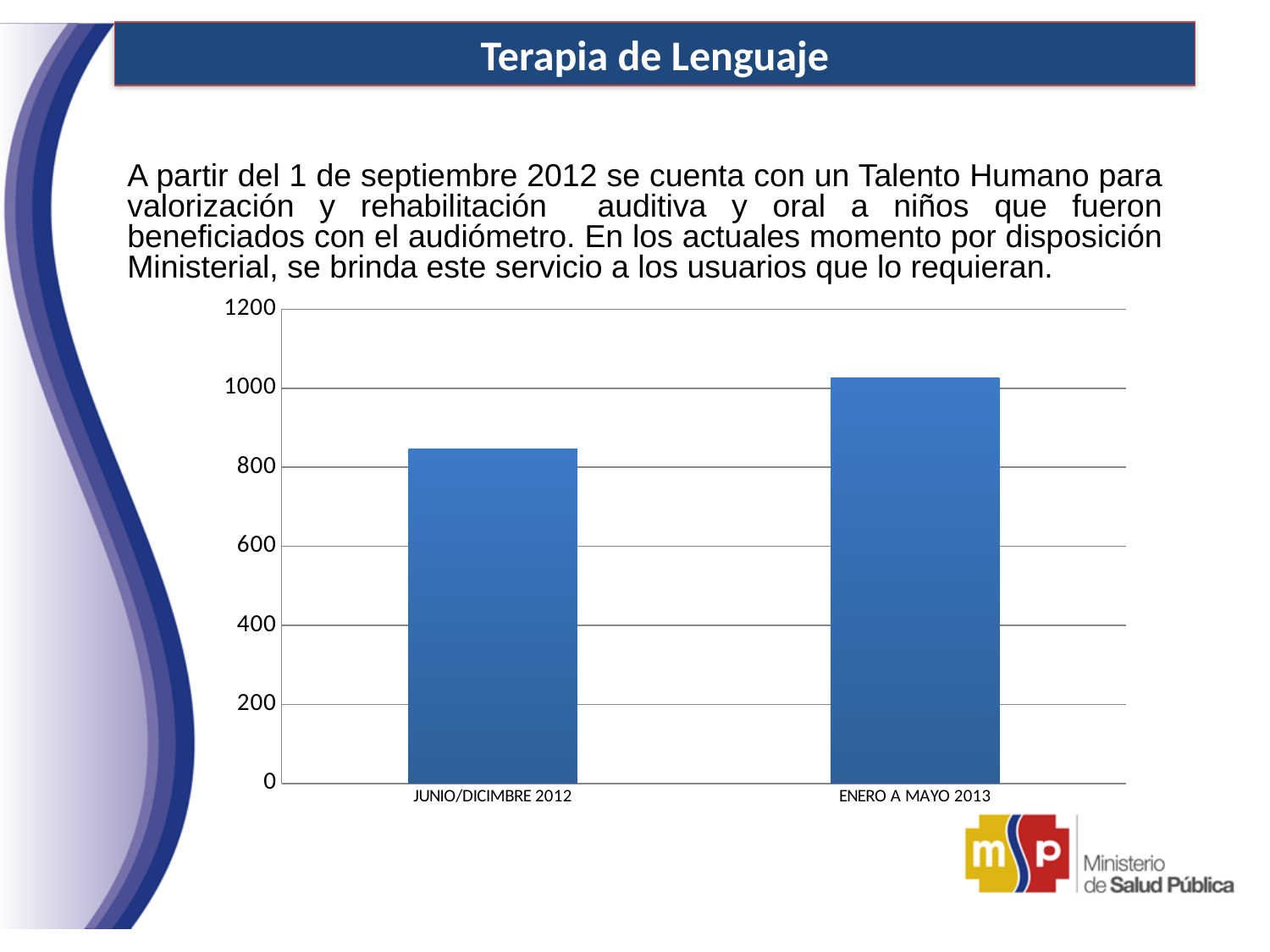
What is the title of the slide containing the chart? Terapia de Lenguaje Which category has the highest bar? ENERO A MAYO 2013 Is the value for ENERO A MAYO 2013 greater or less than 1200? less How many bars does the chart show? 2 Do the values rise or fall from JUNIO/DICIMBRE 2012 to ENERO A MAYO 2013? rise Is the value for ENERO A MAYO 2013 greater or less than 1000? greater What kind of chart is shown on the slide? bar chart What is the highest value shown on the vertical axis of the chart? 1200 Is the value for JUNIO/DICIMBRE 2012 greater or less than 800? greater Which category has the lowest bar? JUNIO/DICIMBRE 2012 Which is larger, the value for JUNIO/DICIMBRE 2012 or the value for ENERO A MAYO 2013? ENERO A MAYO 2013